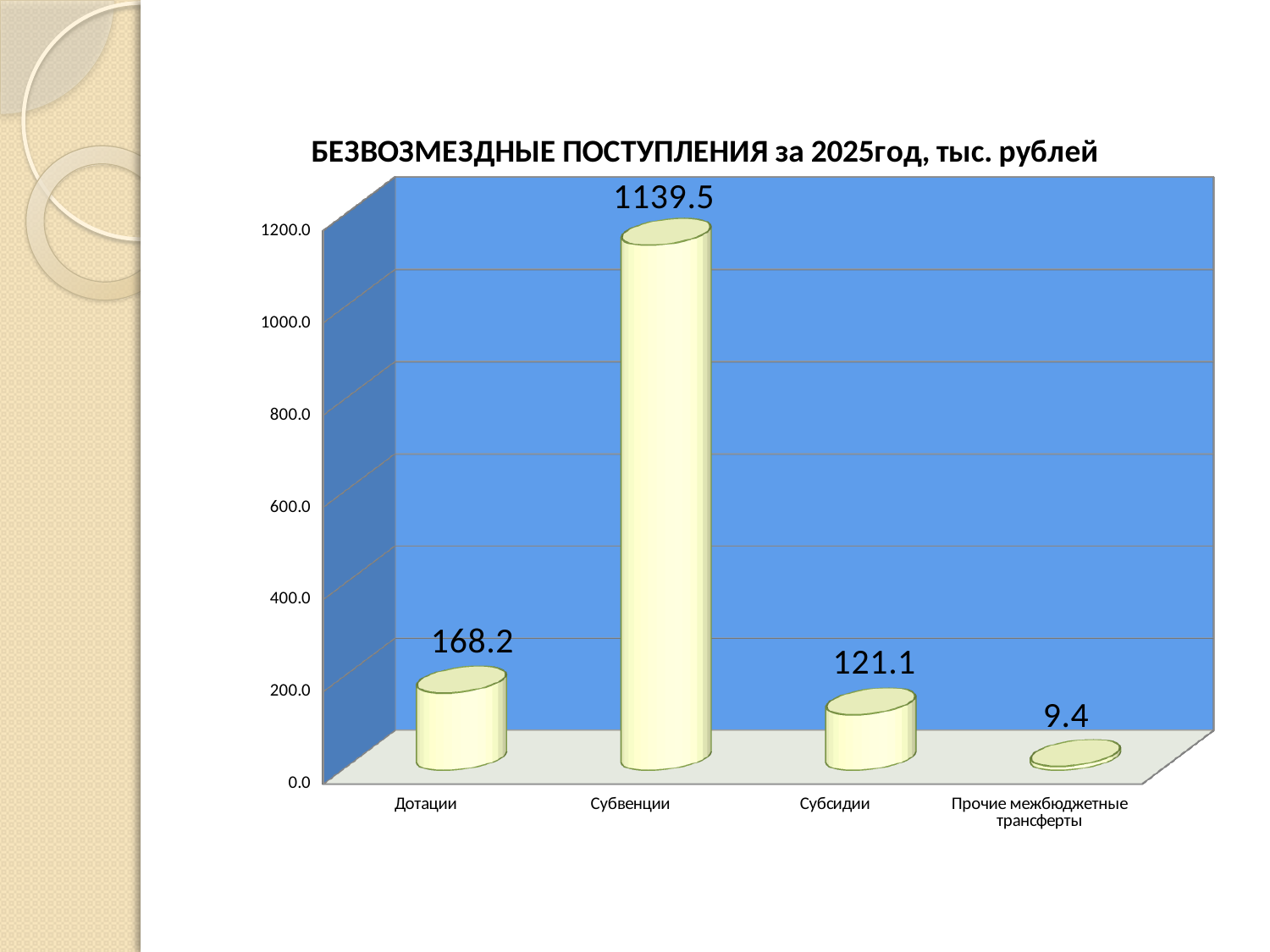
What is the difference between the values for Субвенции and Дотации? 971.3 What is the value for Прочие межбюджетные трансферты? 9.4 Which is larger, the value for Дотации or the value for Субсидии? Дотации What is the value for Дотации? 168.2 Which category has the highest value? Субвенции How many categories are shown on the chart? 4 What is the difference between the values for Дотации and Субсидии? 47.1 Which category has the lowest value? Прочие межбюджетные трансферты What kind of chart is shown on the slide? bar chart What is the value for Субсидии? 121.1 Is the value for Субвенции greater or less than 1000.0? greater What is the value for Субвенции? 1139.5